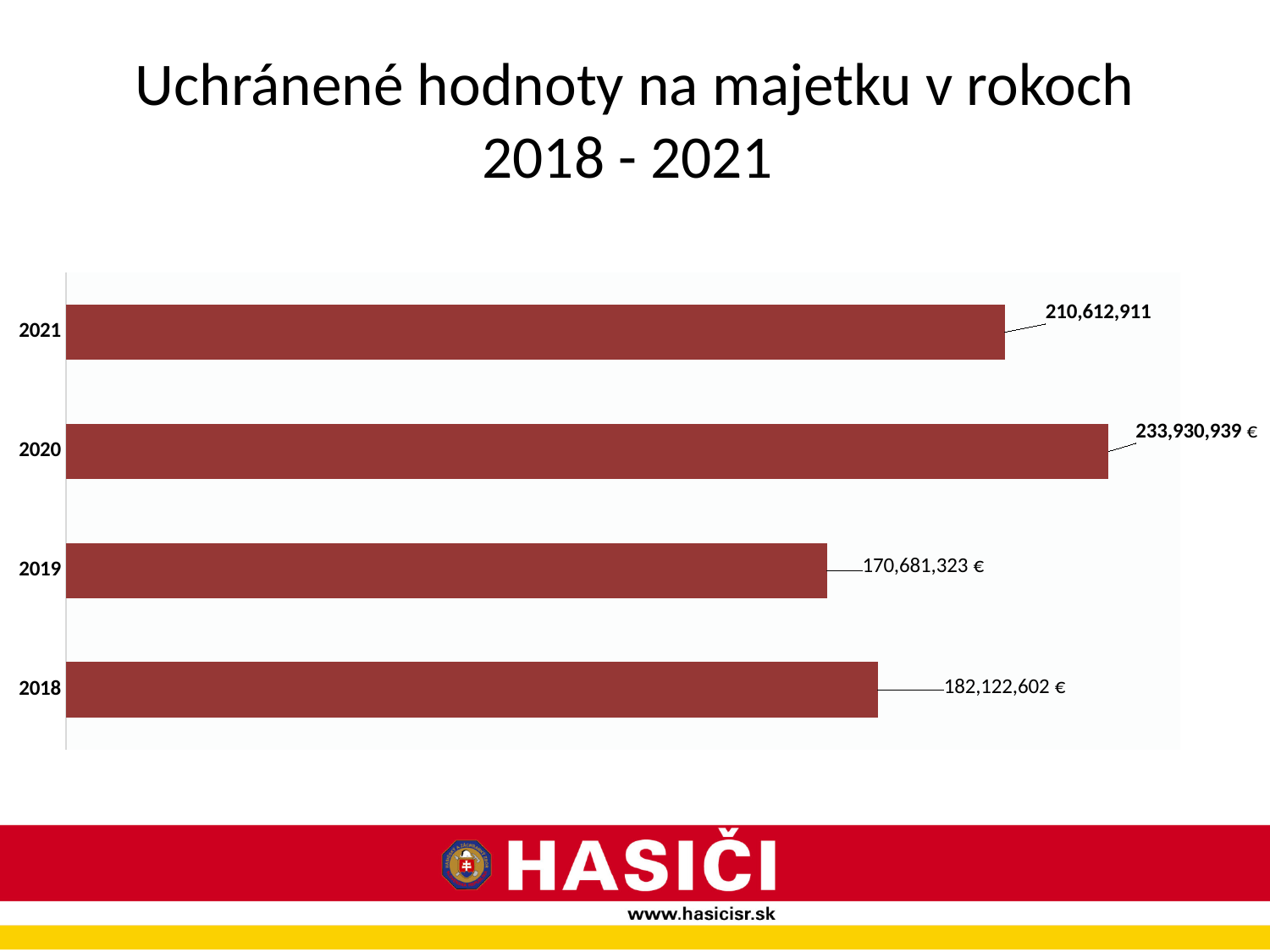
What kind of chart is shown on the slide? Bar chart Which year has the lowest value? 2019 What is the difference between the values for 2020 and 2021? 23,318,028 What is the value shown for 2020? 233,930,939 € What is the value shown for 2019? 170,681,323 € What is the difference between the values for 2018 and 2019? 11,441,279 Which year has the highest value? 2020 What is the value shown for 2021? 210,612,911 How many years are shown in the chart? 4 Did the value rise or fall from 2019 to 2020? Rise Which is larger, the value for 2018 or the value for 2019? 2018 What is the value shown for 2018? 182,122,602 €